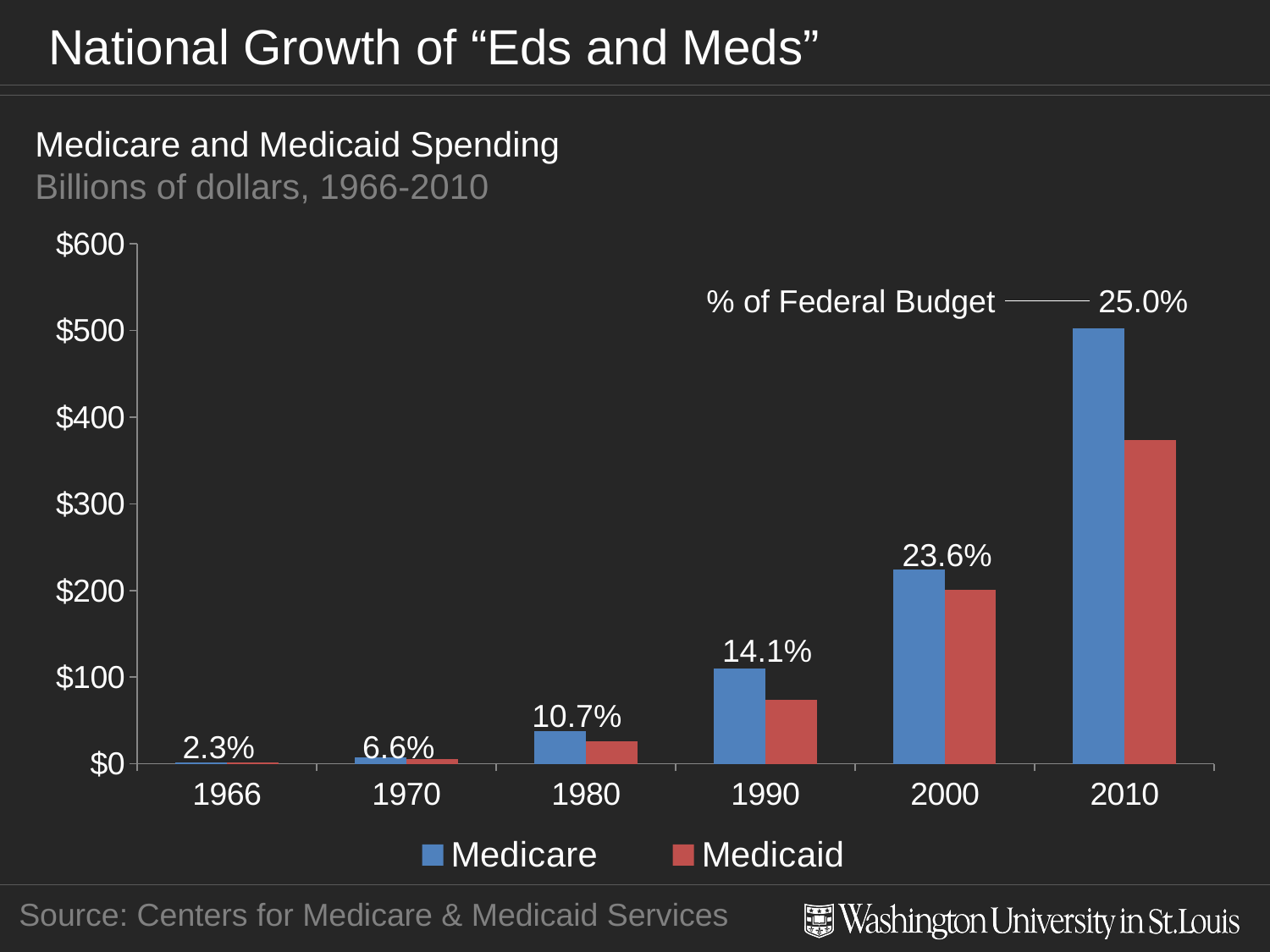
What kind of chart is shown on the slide? Bar chart In which year is Medicare spending highest? 2010 What percentage of the federal budget is labelled for 1990? 14.1% Is Medicare spending in 2010 greater or less than $400? greater By how many percentage points does the % of Federal Budget label for 2000 exceed the label for 1990? 9.5 Do Medicare spending values rise or fall from 1966 to 2010? Rise What percentage of the federal budget is labelled for 1966? 2.3% What percentage of the federal budget is labelled for 2010? 25.0% How many years are shown on the x axis? 6 How many series does the legend list? 2 In 2010, which is larger, Medicare spending or Medicaid spending? Medicare Is Medicaid spending in 2010 greater or less than $400? less